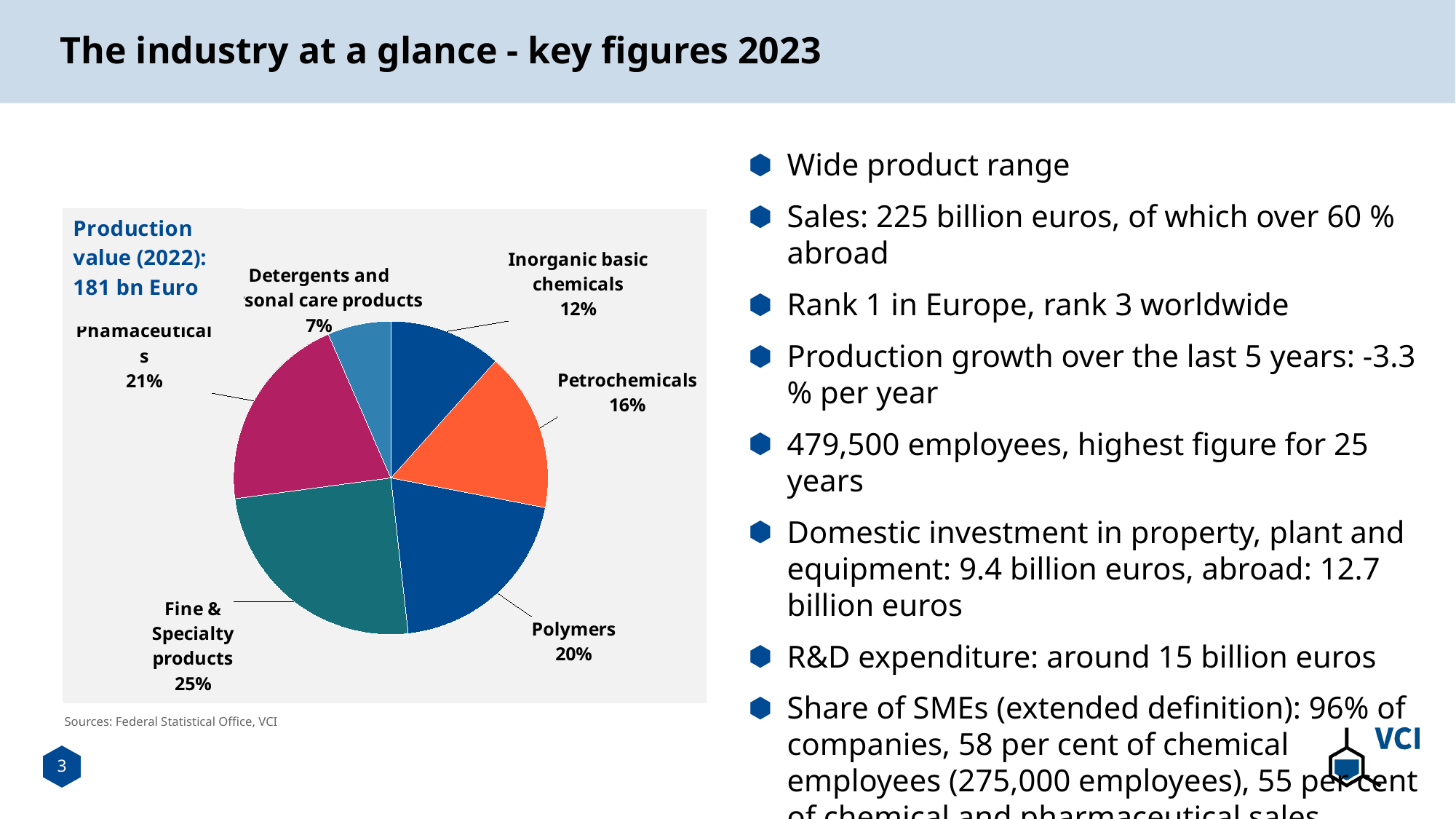
How many slices does the pie chart have? 6 What percentage is shown for Inorganic basic chemicals in the pie chart? 12% Which category has the largest slice in the pie chart? Fine & Specialty products What kind of chart is shown on the slide? pie chart What total production value (2022) is stated in the pie chart's title? 181 bn Euro What share of production value do Polymers account for in the pie chart? 20% What is the difference in percentage points between Fine & Specialty products and Polymers in the pie chart? 5 percentage points Which category has the smallest slice in the pie chart? Detergents and personal care products What is the difference in percentage points between Petrochemicals and Inorganic basic chemicals in the pie chart? 4 percentage points What percentage is shown for Petrochemicals in the pie chart? 16% What share of the pie do Pharmaceuticals represent? 21% Which has the larger share in the pie chart, Pharmaceuticals or Polymers? Pharmaceuticals